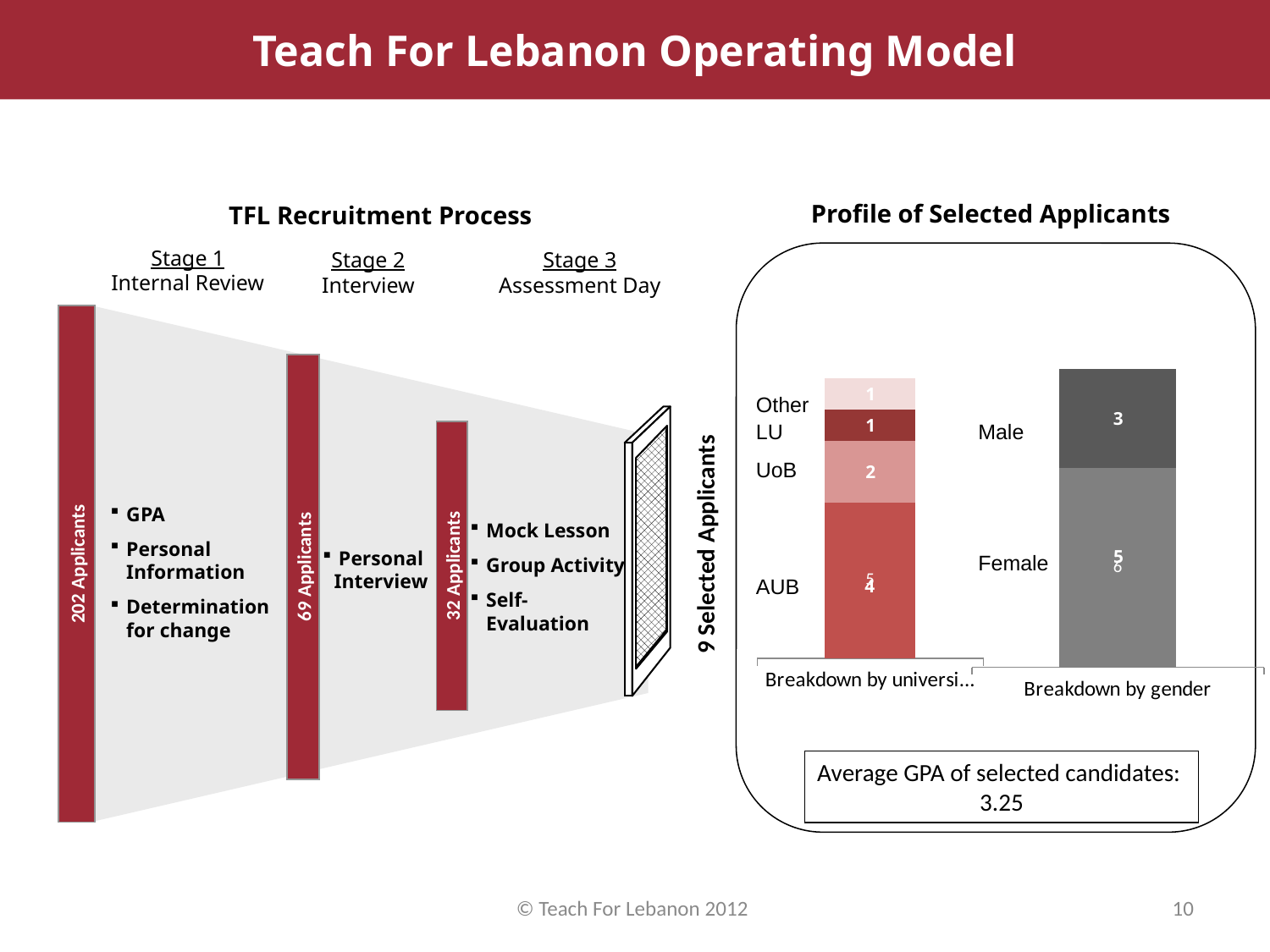
In the 'Breakdown by university' chart, what is the value for UoB? 2 In the 'Breakdown by university' chart, what is the value for Other? 1 In the 'Breakdown by university' chart, what is the difference between the UoB and LU values? 1 What kind of chart is the 'Breakdown by gender' chart? Stacked bar chart In the 'Breakdown by gender' chart, what is the value for Male? 3 How many categories are shown in the 'Breakdown by gender' chart? 2 In the 'Breakdown by gender' chart, which gender has the larger segment? Female In the 'Breakdown by university' chart, which university has the largest segment? AUB How many university categories are shown in the 'Breakdown by university' chart? 4 What is the title of the section containing the two charts on the right of the slide? Profile of Selected Applicants In the 'Breakdown by university' chart, which is larger, UoB or LU? UoB In the 'Breakdown by university' chart, what is the value for LU? 1